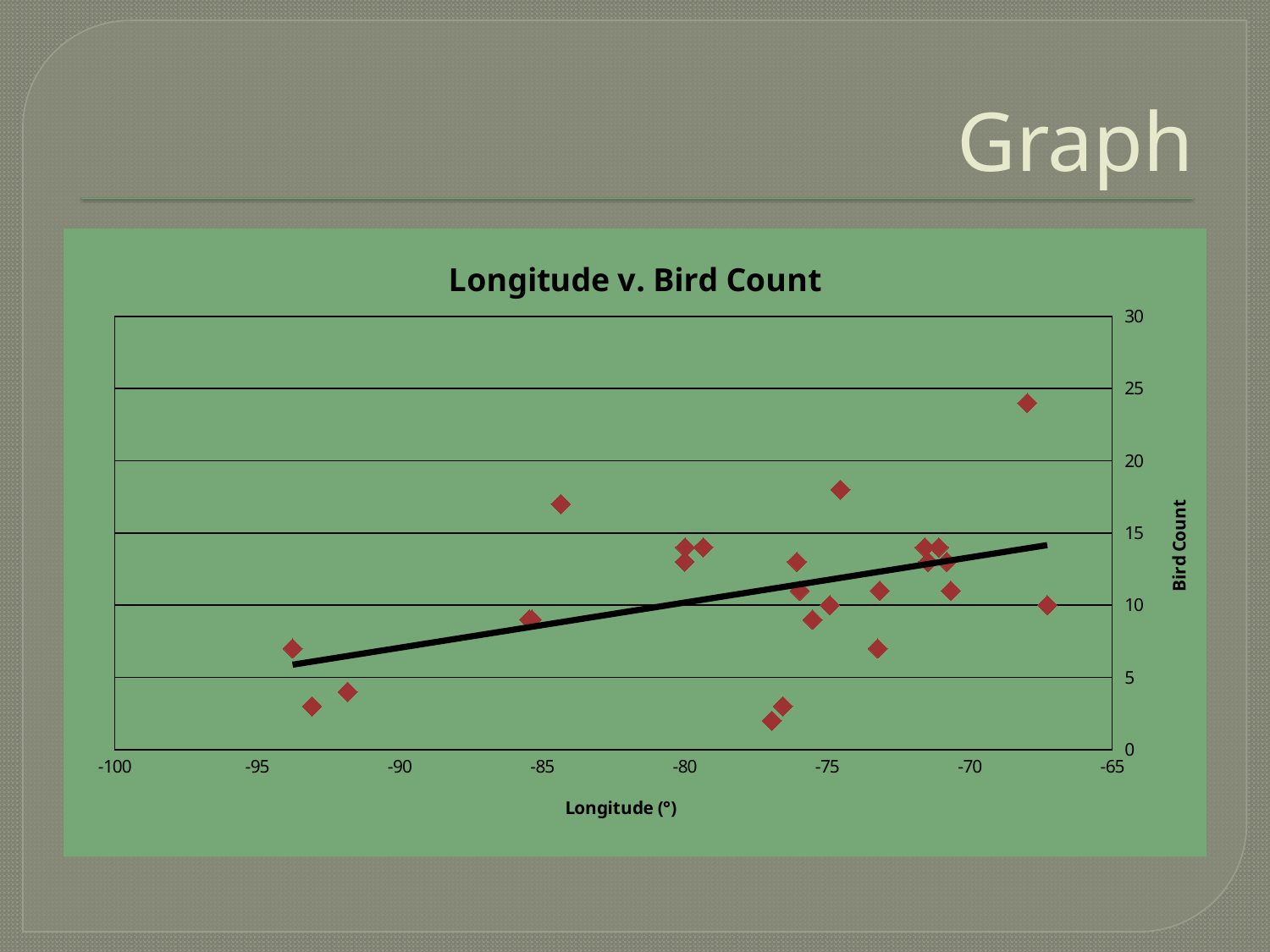
What is the title of the chart? Longitude v. Bird Count Is the bird count of the point plotted near longitude -94 greater or less than 10? less Is the longitude of the point with the highest bird count greater or less than -70? greater Is the lowest bird count plotted greater or less than 5? less Does the trendline rise or fall as longitude increases from -100 to -65? Rises What is the label of the x axis? Longitude (°) Which has the higher bird count: the point near longitude -68 or the point near longitude -67? The point near -68 Which has the higher bird count: the point near longitude -94 or the point near longitude -93? The point near -94 What type of chart is shown on the slide? Scatter chart